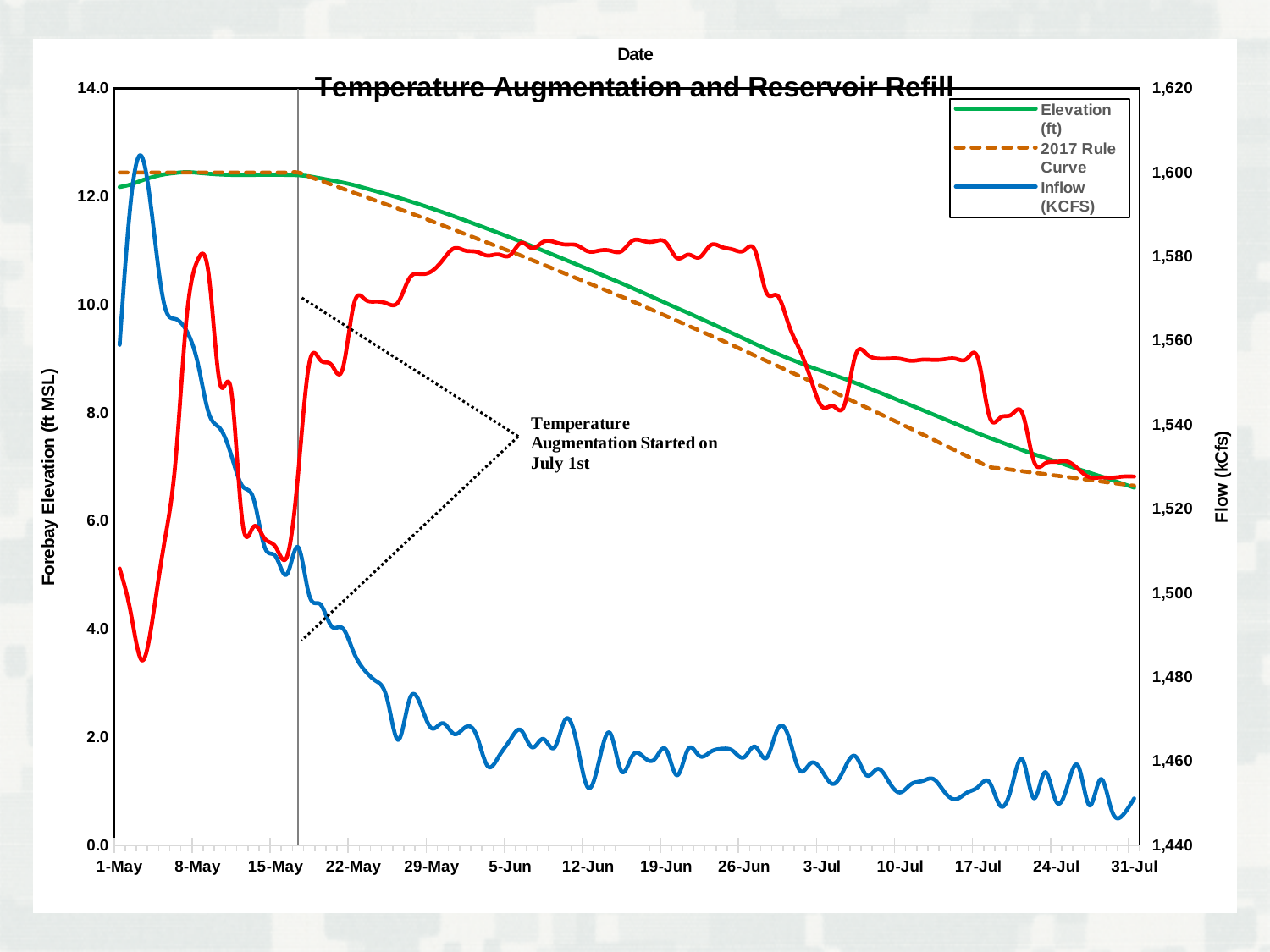
How many series does the legend list? 3 On the left axis scale, is the Inflow (KCFS) line at 31-Jul greater or less than 2.0? less Does the Elevation (ft) line rise or fall between 22-May and 31-Jul? fall What kind of chart is shown on the slide? line chart Does the 2017 Rule Curve line rise or fall between 22-May and 31-Jul? fall According to the annotation on the chart, on what date did temperature augmentation start? July 1st On the right axis scale, is the Elevation (ft) line at 1-May greater or less than 1,580? greater Does the Inflow (KCFS) line rise or fall between 8-May and 31-Jul? fall What is the title of the chart? Temperature Augmentation and Reservoir Refill At 19-Jun, which line is higher: Elevation (ft) or 2017 Rule Curve? Elevation (ft) On the left axis scale, is the peak of the Inflow (KCFS) line in early May greater or less than 10.0? greater